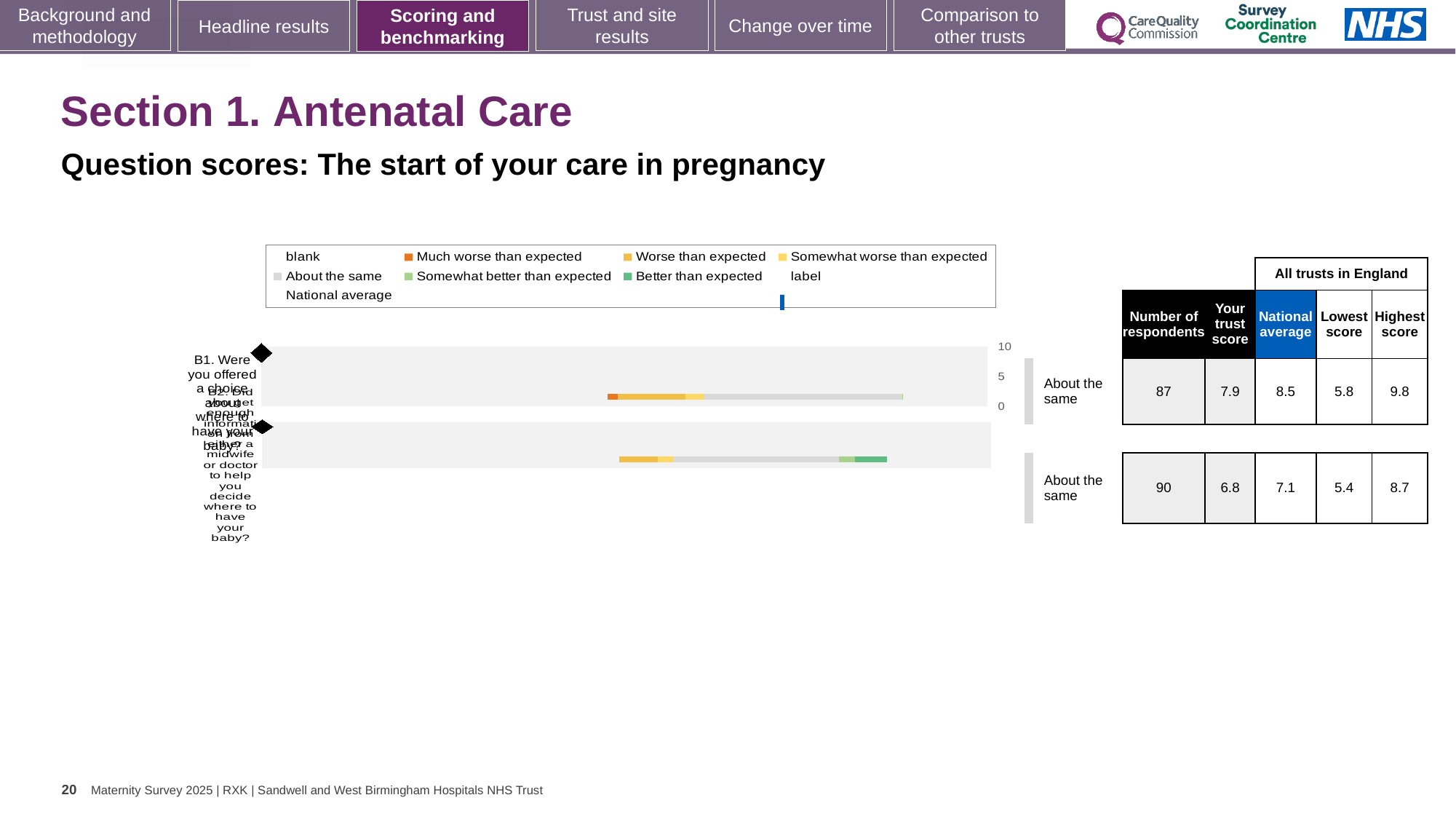
For question B1, which is larger: the trust score or the national average? National average What is the difference between the national average and the trust score for question B2? 0.3 What is the difference between the highest score and the lowest score for question B1? 4.0 Which question has the higher trust score, B1 or B2? B1 How many questions (bars) are plotted in the chart? 2 What is the lowest score among all trusts in England for question B2? 5.4 What benchmark category is shown for question B1? About the same What kind of chart is shown on the slide? bar chart What is the national average for question B1? 8.5 What is the trust score for question B1 (Were you offered a choice about where to have your baby?)? 7.9 What is the highest score among all trusts in England for question B2? 8.7 How many respondents answered question B2? 90